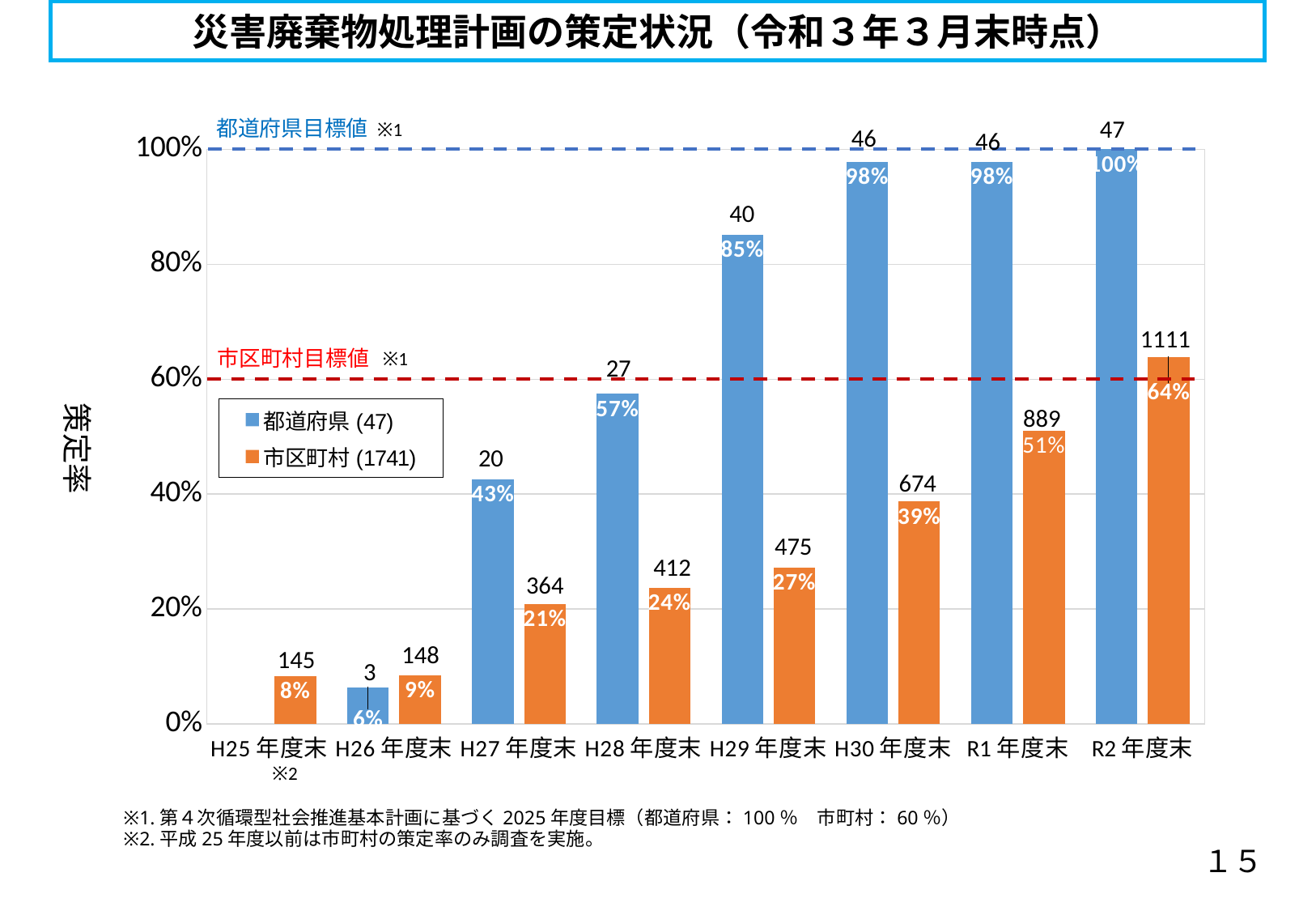
In which fiscal year does the 都道府県 series reach its highest 策定率? R2年度末 What target value does the red dashed line (市区町村目標値) mark on the y axis? 60% How many 市区町村 had a plan at H30年度末, according to the label above the bar? 674 Which is larger at R1年度末: the 都道府県 策定率 or the 市区町村 策定率? 都道府県 What is the 策定率 for 市区町村 at R2年度末? 64% What is the difference between the 都道府県 and 市区町村 策定率 at H28年度末? 33% Does the 市区町村 策定率 generally rise or fall from H25年度末 to R2年度末? rise How many fiscal-year categories are shown on the x axis? 8 What is the 策定率 for 都道府県 at H29年度末? 85% In which fiscal year is the 市区町村 策定率 lowest? H25年度末 What type of chart is shown on the slide? bar chart How many series does the legend list? 2